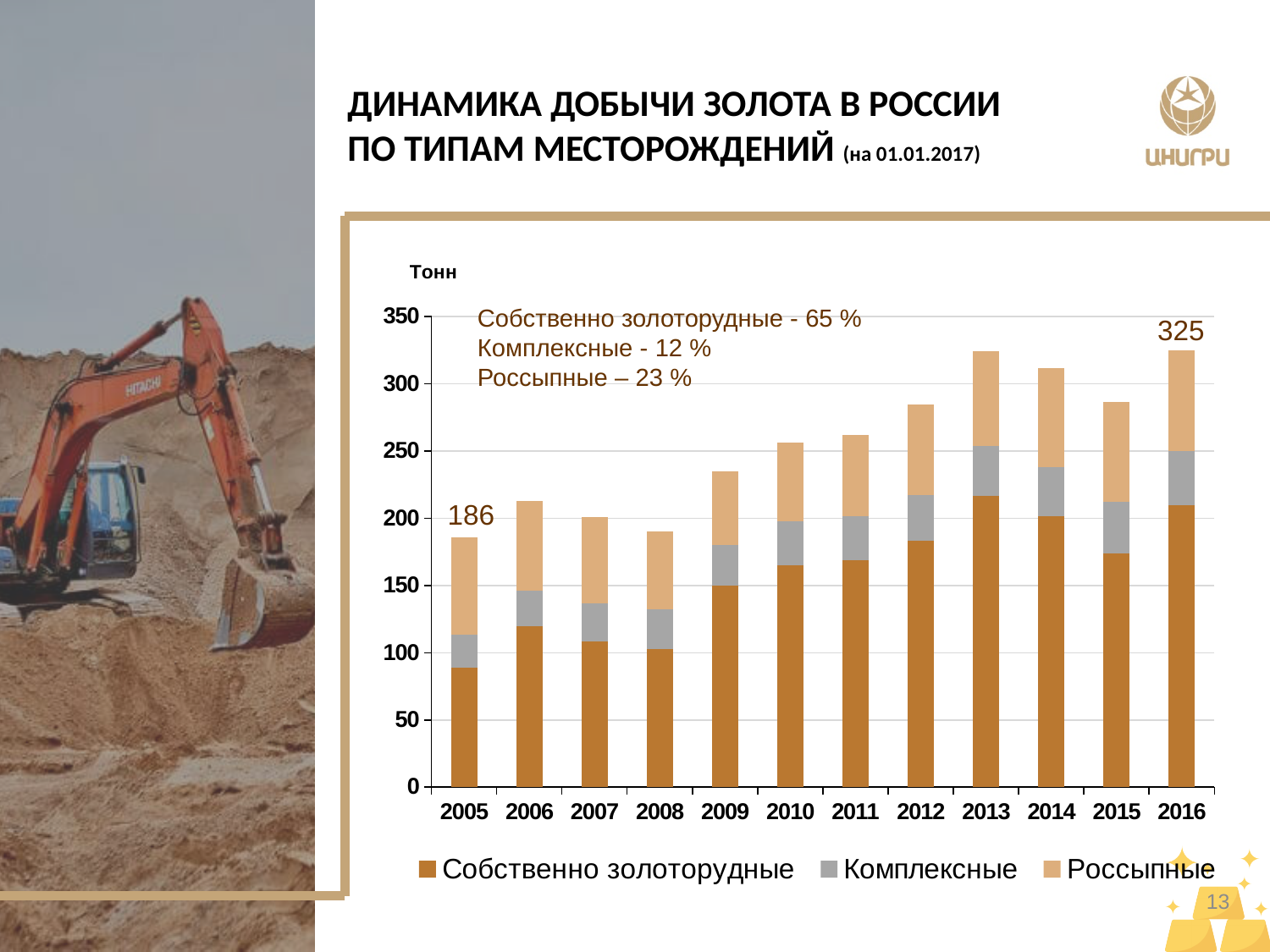
What unit label is printed above the y axis of the chart? Тонн How many series does the chart legend list? 3 By how much does the labelled total for 2016 exceed the labelled total for 2005? 139 Is the total bar height for 2012 greater or less than 300? less What is the total gold production value labelled for 2016? 325 Is the total bar height for 2008 greater or less than 200? less Is the total bar height for 2013 greater or less than 300? greater What is the total gold production value labelled for 2005? 186 Which year has the larger total bar, 2010 or 2007? 2010 What kind of chart is shown on the slide? bar chart Do the total bar heights generally rise or fall from 2005 to 2016? rise How many years are shown on the x axis of the chart? 12